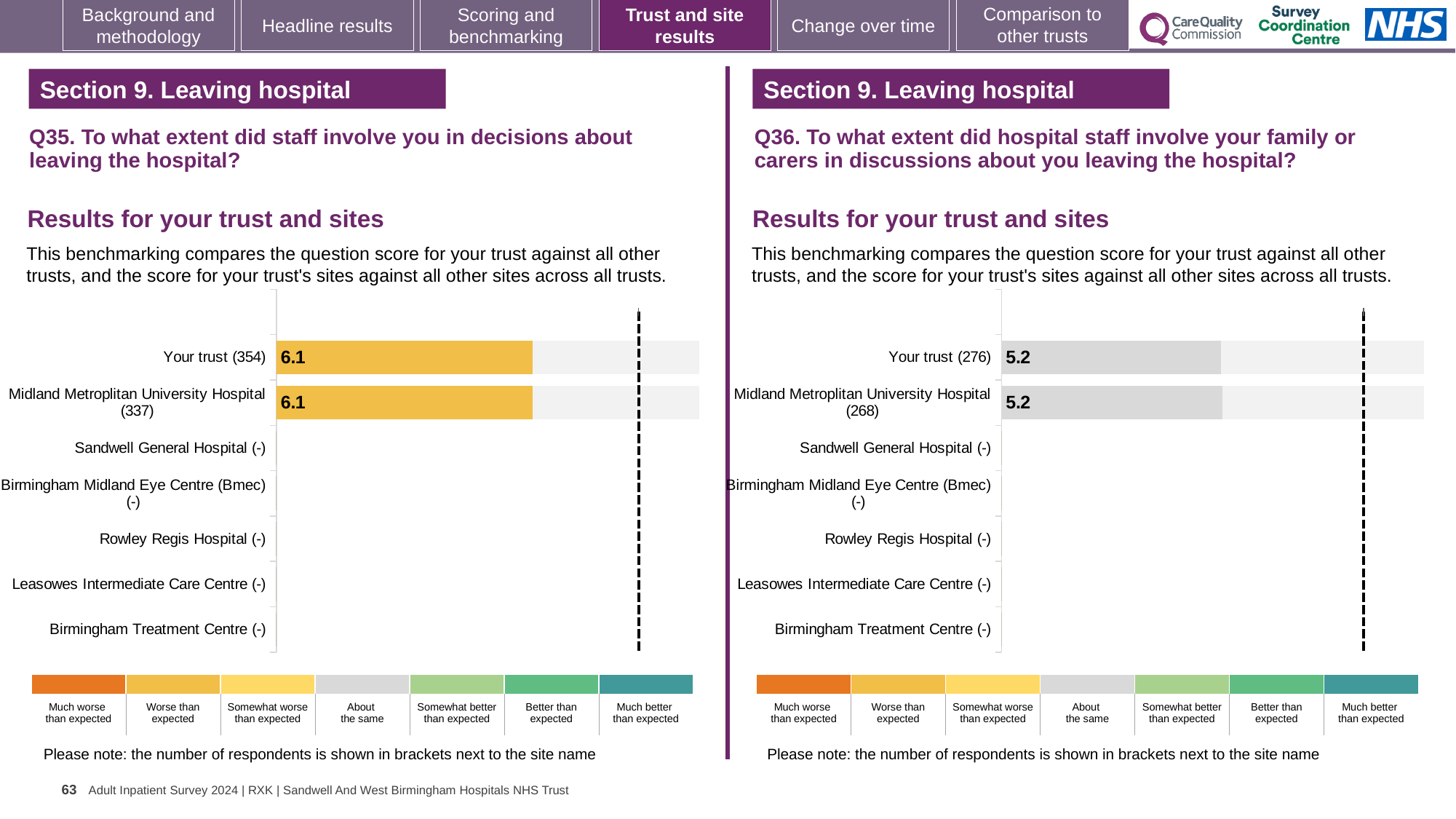
On the Q35 chart (left), which benchmark category does the colour of the Your trust bar correspond to in the legend? Worse than expected What kind of chart is used on the Q36 chart (right)? Bar chart On the Q35 chart (left), what is the difference between the score for Your trust and the score for Midland Metroplitan University Hospital? 0.0 On the Q35 chart (left), what is the score for Your trust? 6.1 On the Q35 chart (left), how many site or trust categories are listed on the vertical axis? 7 On the Q36 chart (right), what is the score for Your trust? 5.2 On the Q35 chart (left), how many respondents are shown in brackets for Your trust? 354 On the Q36 chart (right), which benchmark category does the colour of the Your trust bar correspond to in the legend? About the same On the Q36 chart (right), how many respondents are shown in brackets for Midland Metroplitan University Hospital? 268 On the Q35 chart (left), what is the score for Midland Metroplitan University Hospital? 6.1 On the Q36 chart (right), what is the score for Midland Metroplitan University Hospital? 5.2 Is the score for Your trust on the Q35 chart (left) larger or smaller than the score for Your trust on the Q36 chart (right)? Larger